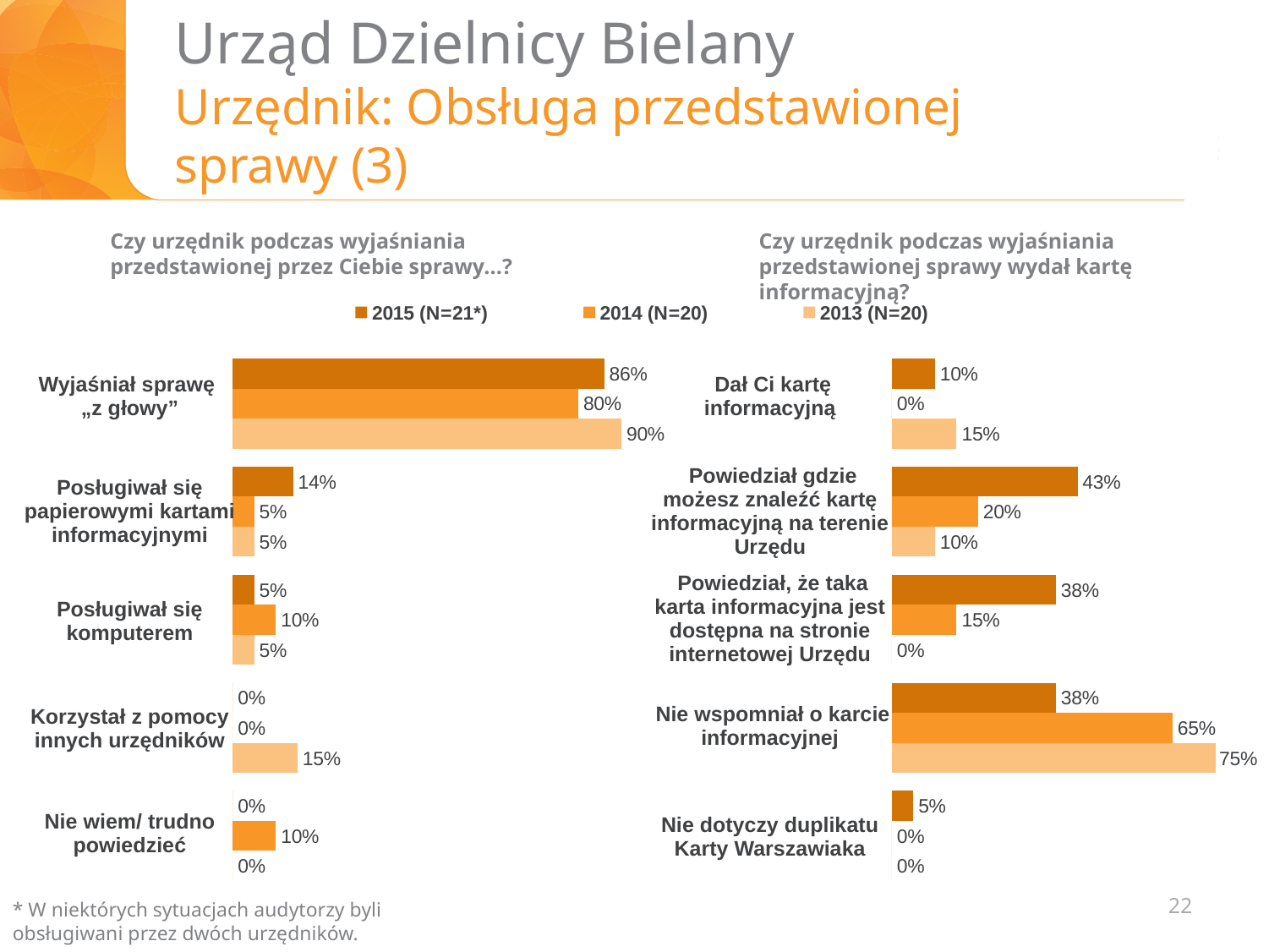
How many categories does the left chart show? 5 How many series does the legend list? 3 What type of chart is the right chart ("Czy urzędnik podczas wyjaśniania przedstawionej sprawy wydał kartę informacyjną?")? Bar chart In the right chart, what is the 2013 value for "Powiedział, że taka karta informacyjna jest dostępna na stronie internetowej Urzędu"? 0% In the left chart ("Czy urzędnik podczas wyjaśniania przedstawionej przez Ciebie sprawy...?"), what is the 2015 value for "Wyjaśniał sprawę „z głowy”"? 86% In the left chart, which category has the highest 2014 value? Wyjaśniał sprawę „z głowy” In the left chart, what is the 2013 value for "Korzystał z pomocy innych urzędników"? 15% In the right chart, which category has the highest 2013 value? Nie wspomniał o karcie informacyjnej In the left chart, what is the difference between the 2013 and 2014 values for "Wyjaśniał sprawę „z głowy”"? 10% In the right chart, what is the 2015 value for "Powiedział gdzie możesz znaleźć kartę informacyjną na terenie Urzędu"? 43% In the right chart, what is the difference between the 2014 and 2015 values for "Nie wspomniał o karcie informacyjnej"? 27% In the left chart, which is larger for "Posługiwał się komputerem": the 2015 value or the 2014 value? 2014